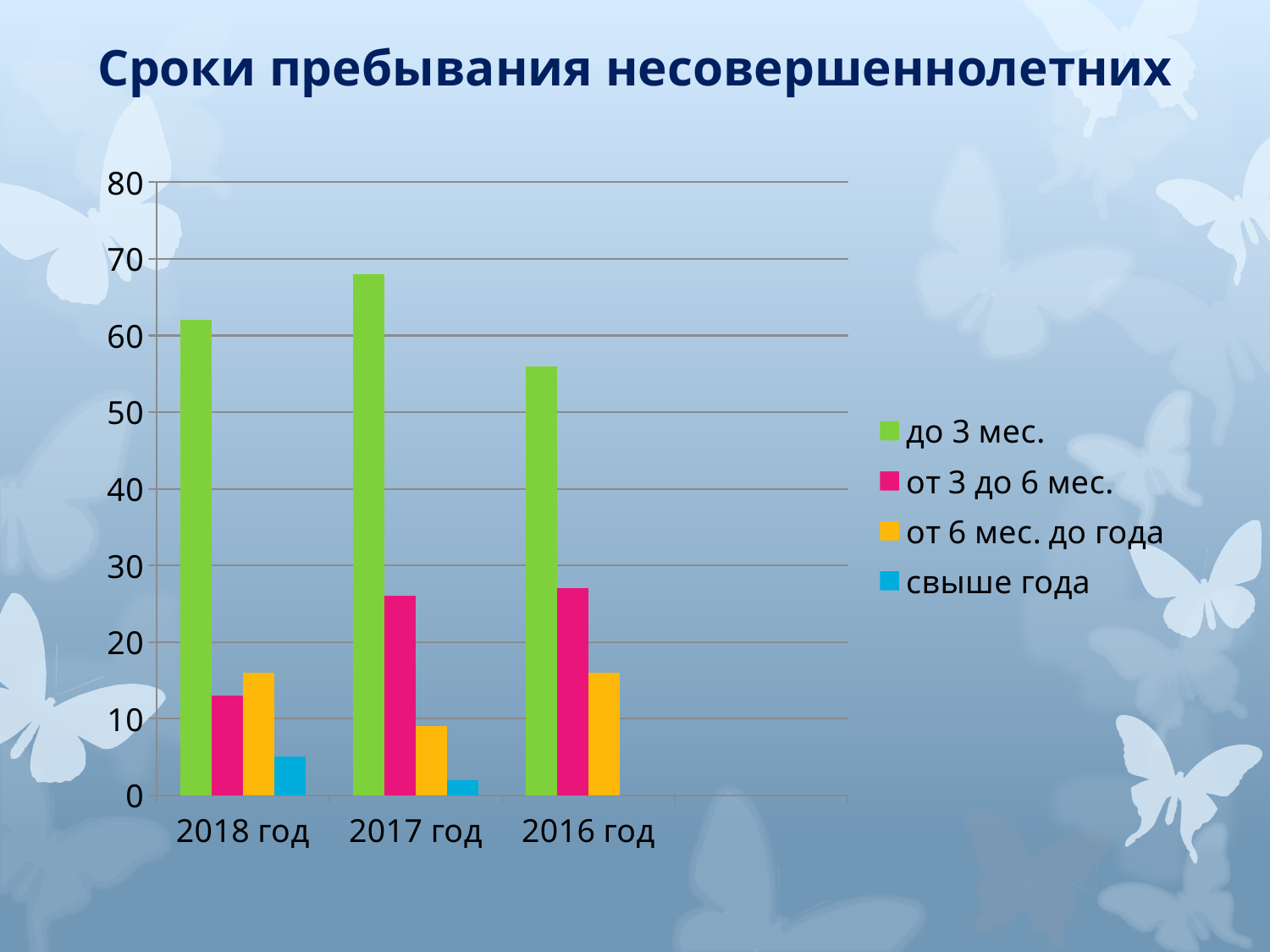
What is the title of the slide? Сроки пребывания несовершеннолетних Is the value for "от 3 до 6 мес." in 2018 год greater or less than 20? less Which year has the highest value for "до 3 мес."? 2017 год Which is larger for "от 3 до 6 мес.": 2018 год or 2017 год? 2017 год Which is larger for "от 6 мес. до года": 2017 год or 2018 год? 2018 год Is the value for "свыше года" in 2018 год greater or less than 10? less Is the value for "до 3 мес." in 2017 год greater or less than 60? greater Which year has the lowest value for "до 3 мес."? 2016 год How many series does the legend list? 4 What kind of chart is shown on the slide? bar chart How many year categories are shown on the x axis? 3 Does the value for "от 3 до 6 мес." rise or fall moving left to right along the x axis from 2018 год to 2016 год? rise